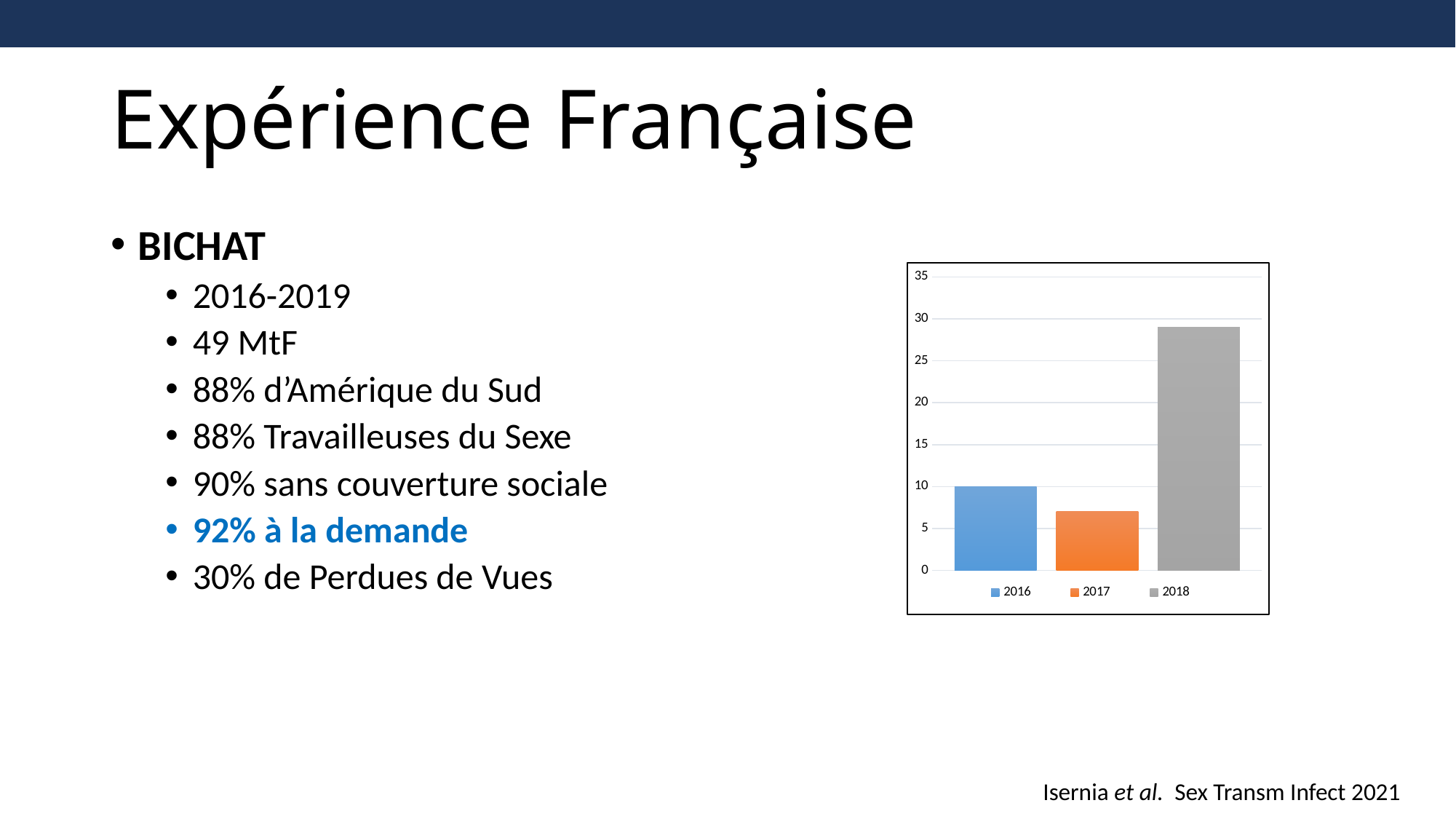
Which year has the highest bar in the chart? 2018 Which is larger in the chart, the value for 2016 or the value for 2017? 2016 Which year has the lowest bar in the chart? 2017 Does the value rise or fall from 2017 to 2018 in the chart? rise Is the value for 2017 greater or less than 5? greater What kind of chart is shown on the slide? bar chart How many series does the chart legend list? 3 What colour is the bar for 2018 in the chart? grey Is the value for 2018 greater or less than 30? less What is the value for 2016 in the chart? 10 How many bars are plotted in the chart? 3 Is the value for 2018 greater or less than 25? greater